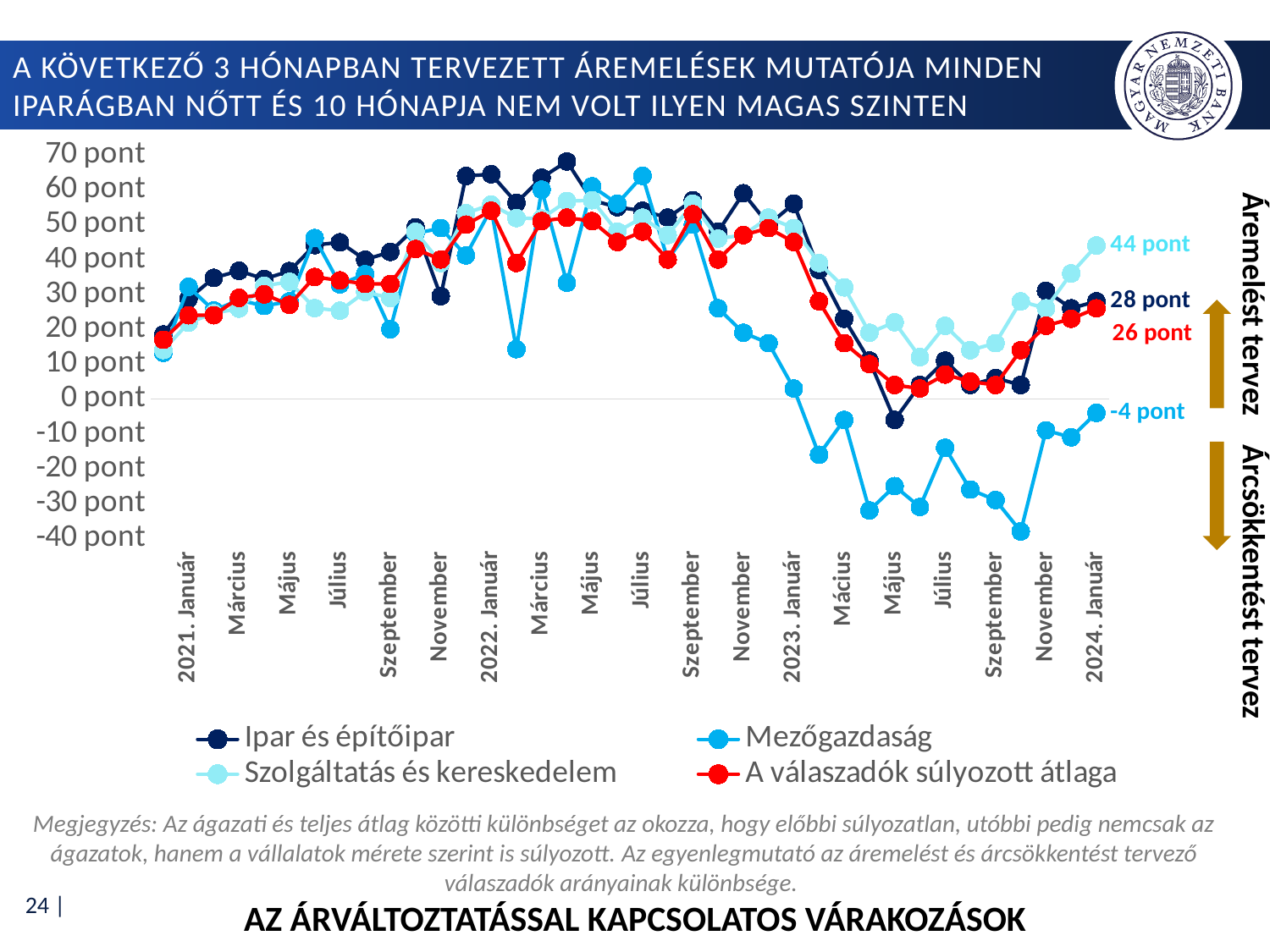
What is the value for Szolgáltatás és kereskedelem in 2024. Január? 44 pont How many series does the legend list? 4 What kind of chart is shown on the slide? line chart What is the value for A válaszadók súlyozott átlaga in 2024. Január? 26 pont What is the value for Mezőgazdaság in 2024. Január? -4 pont Which series has the highest value in 2024. Január? Szolgáltatás és kereskedelem What is the value for Ipar és építőipar in 2024. Január? 28 pont What colour is the line for A válaszadók súlyozott átlaga? red In 2024. Január, which is larger: Ipar és építőipar or A válaszadók súlyozott átlaga? Ipar és építőipar What is the difference between the 2024. Január values of Szolgáltatás és kereskedelem and Mezőgazdaság? 48 pont Which series has the lowest value in 2024. Január? Mezőgazdaság Is the value for Ipar és építőipar in 2023 Május greater or less than 0 pont? less